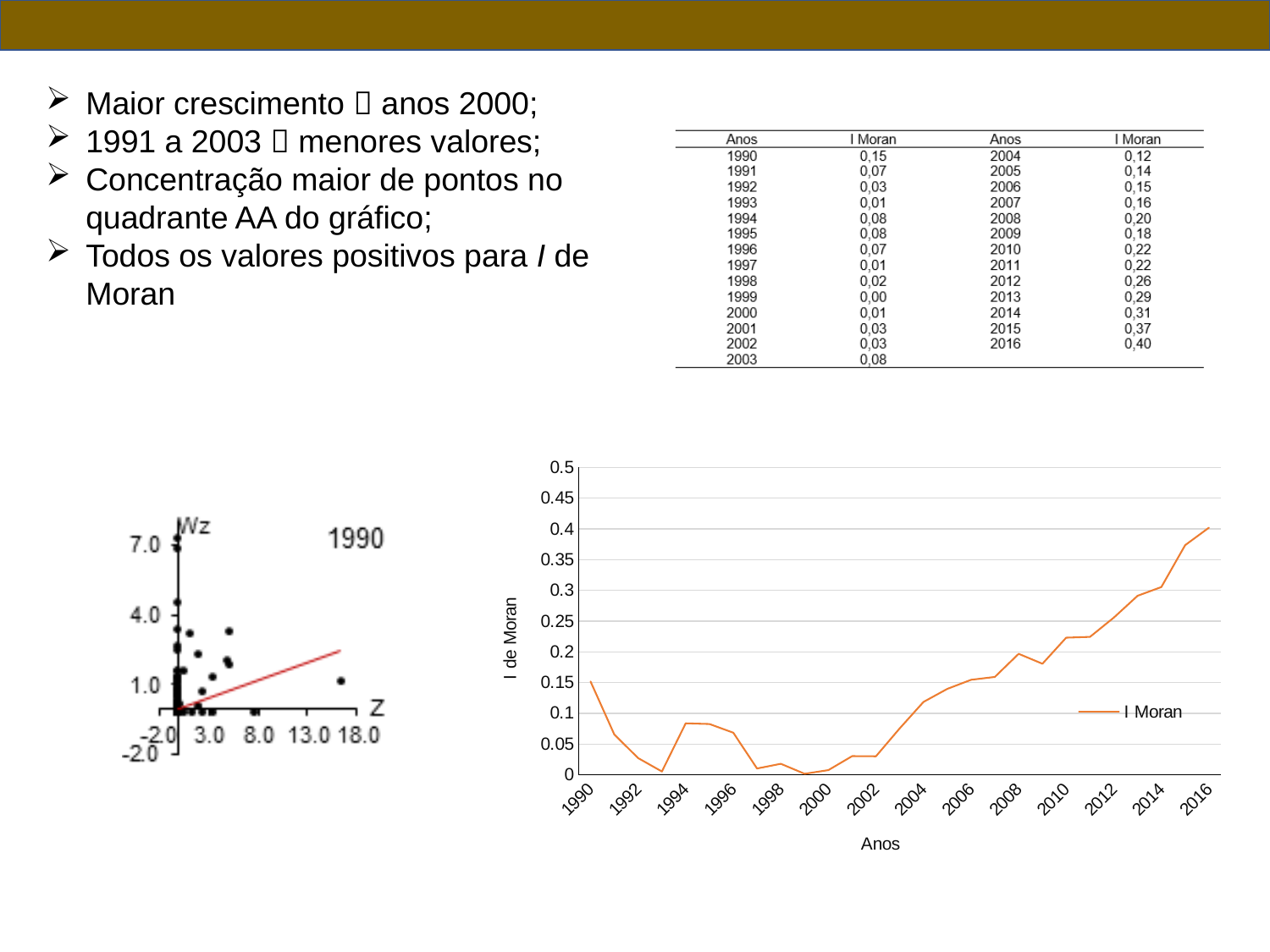
In the line chart, what is the I Moran value for 2016? 0.4 How many series does the legend of the line chart list? 1 In the line chart, which year has the highest I Moran value? 2016 In the line chart, is the I Moran value for 1991 greater or less than 0.1? less What is the legend entry of the line chart? I Moran In the line chart, which year has the larger I Moran value, 2000 or 2010? 2010 What kind of chart is the chart on the right with the x axis labelled Anos? line chart In the line chart, do the I Moran values rise or fall from 2004 to 2016? rise What kind of chart is the small chart on the left labelled 1990 with axes Wz and Z? scatter chart What is the y-axis title of the line chart? I de Moran In the line chart, is the I Moran value for 2015 greater or less than 0.3? greater In the line chart, is the I Moran value for 2013 greater or less than 0.25? greater